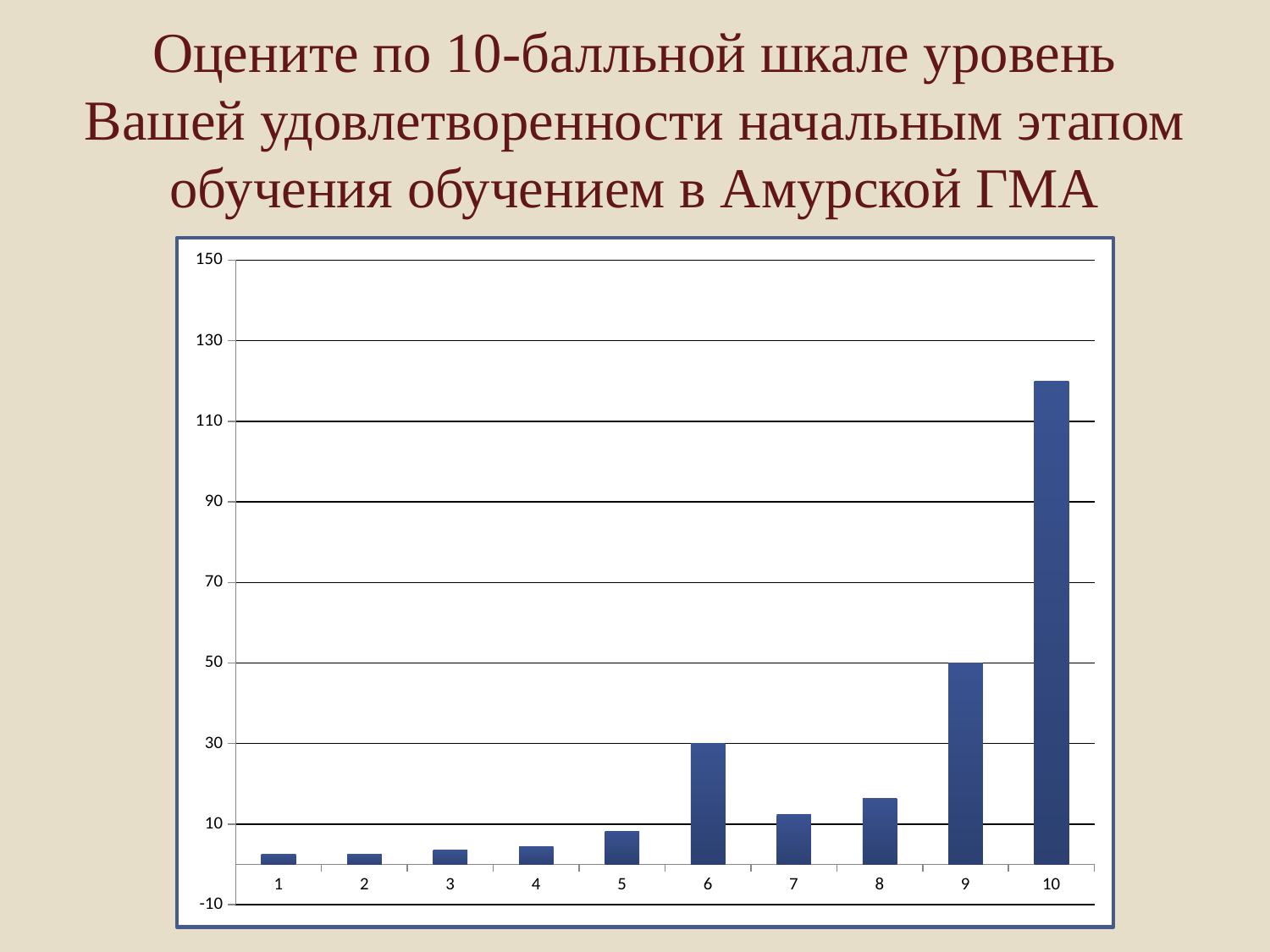
What is the highest value shown on the y axis of the chart? 150 What is the difference between the values for category 9 and category 6? 20 What kind of chart is shown on the slide? bar chart How many categories are shown on the x axis of the chart? 10 Is the value for category 5 greater or less than 10? less What is the value for category 9? 50 Which category has the highest bar in the chart? 10 Which is larger, the value for category 9 or the value for category 7? 9 Is the value for category 10 greater or less than 110? greater Do the values generally rise or fall as the categories go from 1 to 10? rise Is the value for category 8 greater or less than 10? greater What is the value for category 6? 30